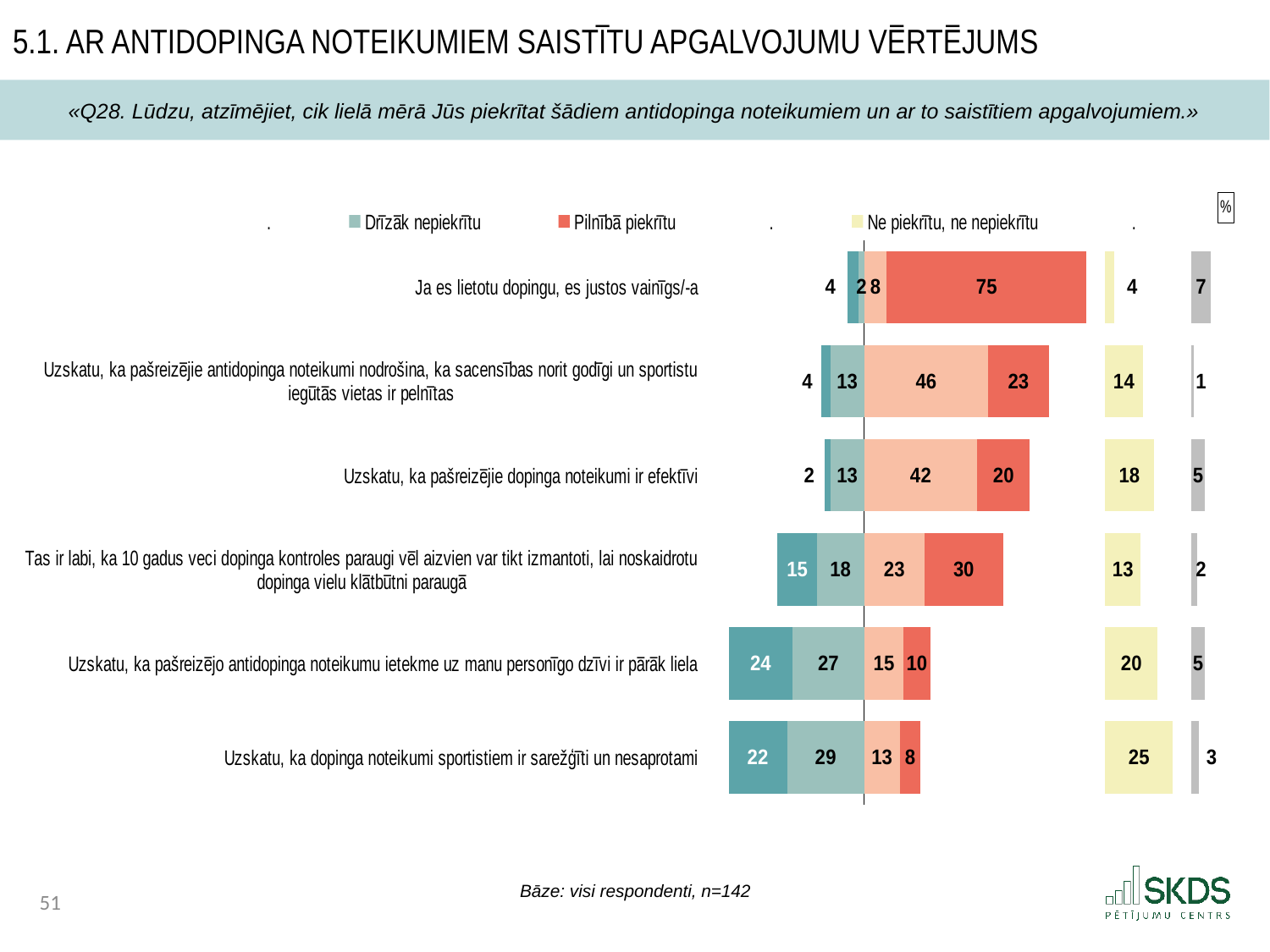
How many statements are shown in the chart? 6 Which statement has the highest "Ne piekrītu, ne nepiekrītu" value? Uzskatu, ka dopinga noteikumi sportistiem ir sarežģīti un nesaprotami Which statement has the lowest "Pilnībā piekrītu" value? Uzskatu, ka dopinga noteikumi sportistiem ir sarežģīti un nesaprotami Which statement has a larger "Pilnībā piekrītu" value: "Tas ir labi, ka 10 gadus veci dopinga kontroles paraugi vēl aizvien var tikt izmantoti..." or "Uzskatu, ka pašreizējie dopinga noteikumi ir efektīvi"? Tas ir labi, ka 10 gadus veci dopinga kontroles paraugi vēl aizvien var tikt izmantoti, lai noskaidrotu dopinga vielu klātbūtni paraugā What colour represents "Pilnībā piekrītu" in the chart? Red What percentage of respondents fully agree (Pilnībā piekrītu) with the statement "Ja es lietotu dopingu, es justos vainīgs/-a"? 75 Which statement has the highest "Pilnībā piekrītu" value? Ja es lietotu dopingu, es justos vainīgs/-a What is the difference between the "Pilnībā piekrītu" values for "Ja es lietotu dopingu, es justos vainīgs/-a" and "Uzskatu, ka pašreizējie dopinga noteikumi ir efektīvi"? 55 What is the "Ne piekrītu, ne nepiekrītu" value for the statement "Uzskatu, ka pašreizējie dopinga noteikumi ir efektīvi"? 18 Which statement has the lowest "Ne piekrītu, ne nepiekrītu" value? Ja es lietotu dopingu, es justos vainīgs/-a What is the "Drīzāk nepiekrītu" value for the statement "Uzskatu, ka dopinga noteikumi sportistiem ir sarežģīti un nesaprotami"? 29 What kind of chart is shown on the slide? Bar chart